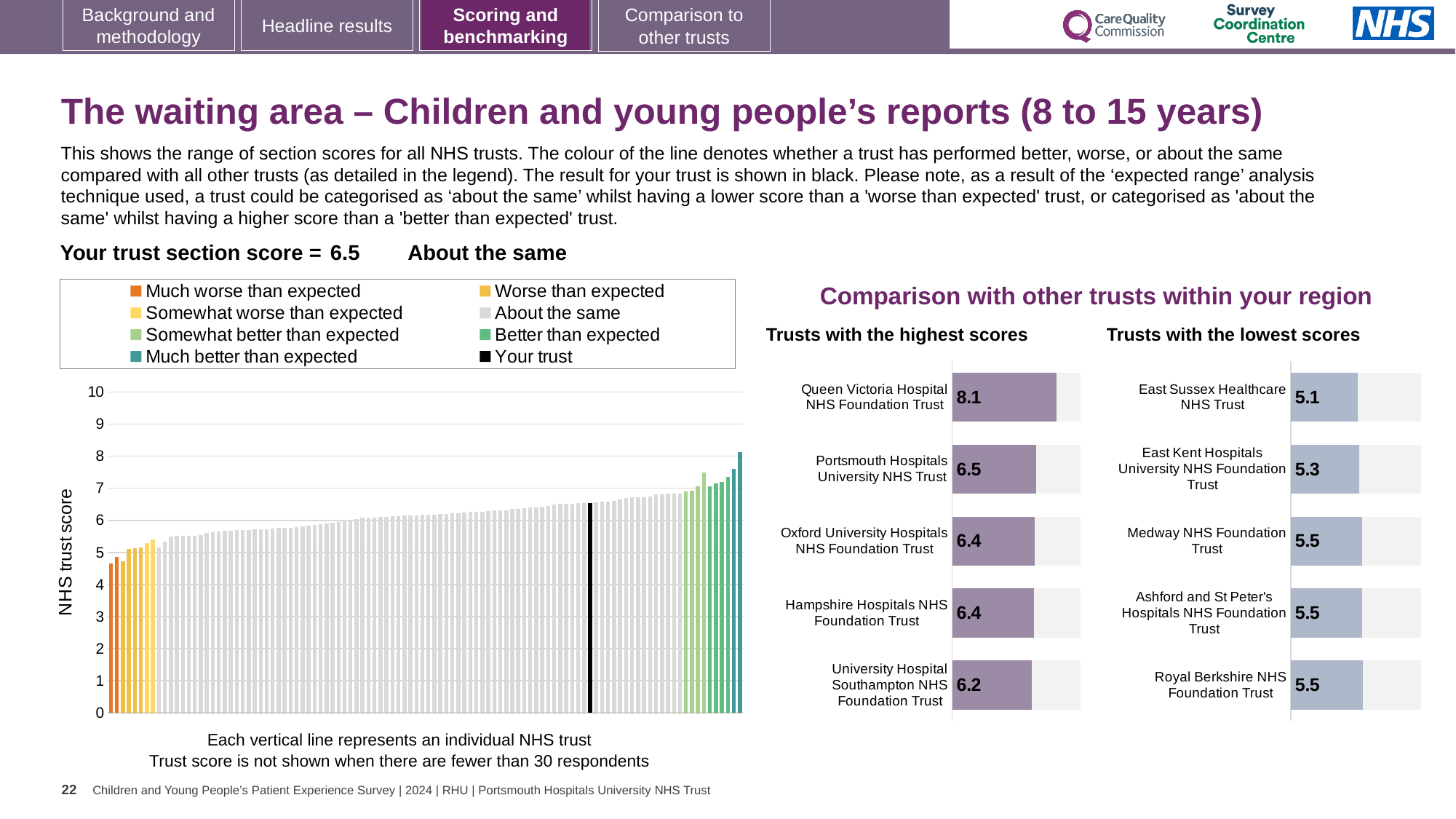
In the 'Trusts with the lowest scores' chart, what is the score for East Kent Hospitals University NHS Foundation Trust? 5.3 In the 'Trusts with the lowest scores' chart, how many trusts are shown? 5 In the 'Trusts with the highest scores' chart, what is the score for University Hospital Southampton NHS Foundation Trust? 6.2 In the 'Trusts with the lowest scores' chart, what is the difference between the scores of Royal Berkshire NHS Foundation Trust and East Sussex Healthcare NHS Trust? 0.4 In the 'Trusts with the highest scores' chart, which trust has the highest score? Queen Victoria Hospital NHS Foundation Trust How many entries does the legend of the NHS trust score chart on the left list? 8 In the NHS trust score chart on the left, what is the section score for your trust (the black bar)? 6.5 In the 'Trusts with the highest scores' chart, what is the score for Queen Victoria Hospital NHS Foundation Trust? 8.1 In the 'Trusts with the lowest scores' chart, which trust has the lowest score? East Sussex Healthcare NHS Trust In the NHS trust score chart on the left, do the trust scores rise or fall from left to right? rise In the 'Trusts with the highest scores' chart, what is the difference between the scores of Queen Victoria Hospital NHS Foundation Trust and Portsmouth Hospitals University NHS Trust? 1.6 In the 'Trusts with the lowest scores' chart, which has the larger score, East Kent Hospitals University NHS Foundation Trust or East Sussex Healthcare NHS Trust? East Kent Hospitals University NHS Foundation Trust